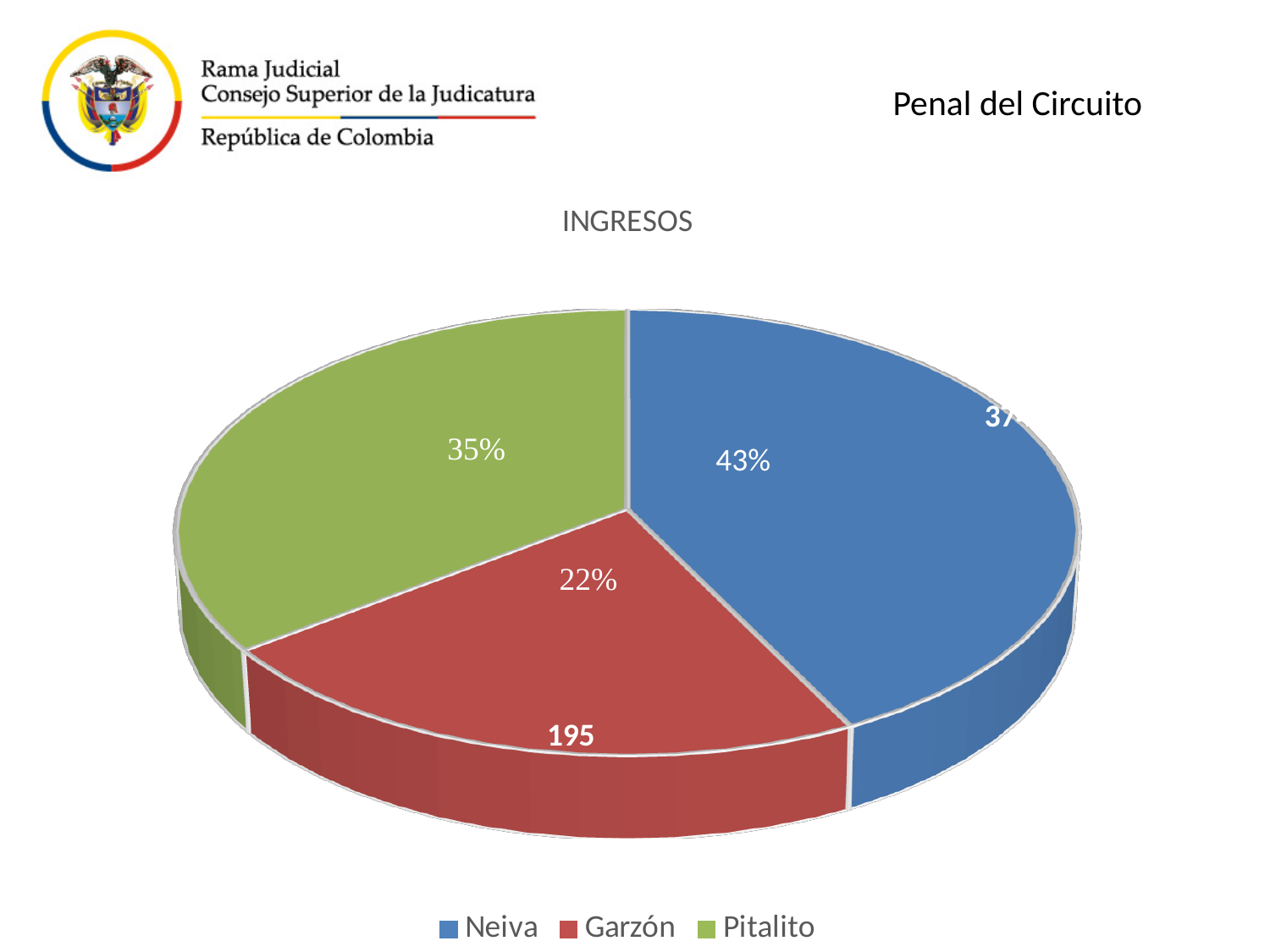
What percentage share does Garzón have in the INGRESOS pie chart? 22% What percentage share does Neiva have in the INGRESOS pie chart? 43% Which category has the smallest slice in the INGRESOS pie chart? Garzón How many categories does the INGRESOS pie chart show? 3 What colour is the Pitalito slice in the INGRESOS pie chart? green What type of chart is shown on the slide? pie chart What value is printed on the Garzón slice of the INGRESOS pie chart besides its percentage? 195 Which has a larger share in the INGRESOS pie chart, Pitalito or Garzón? Pitalito What is the difference in percentage points between Neiva's share and Garzón's share? 21 What percentage share does Pitalito have in the INGRESOS pie chart? 35% Which category has the largest slice in the INGRESOS pie chart? Neiva What is the title of the chart? INGRESOS